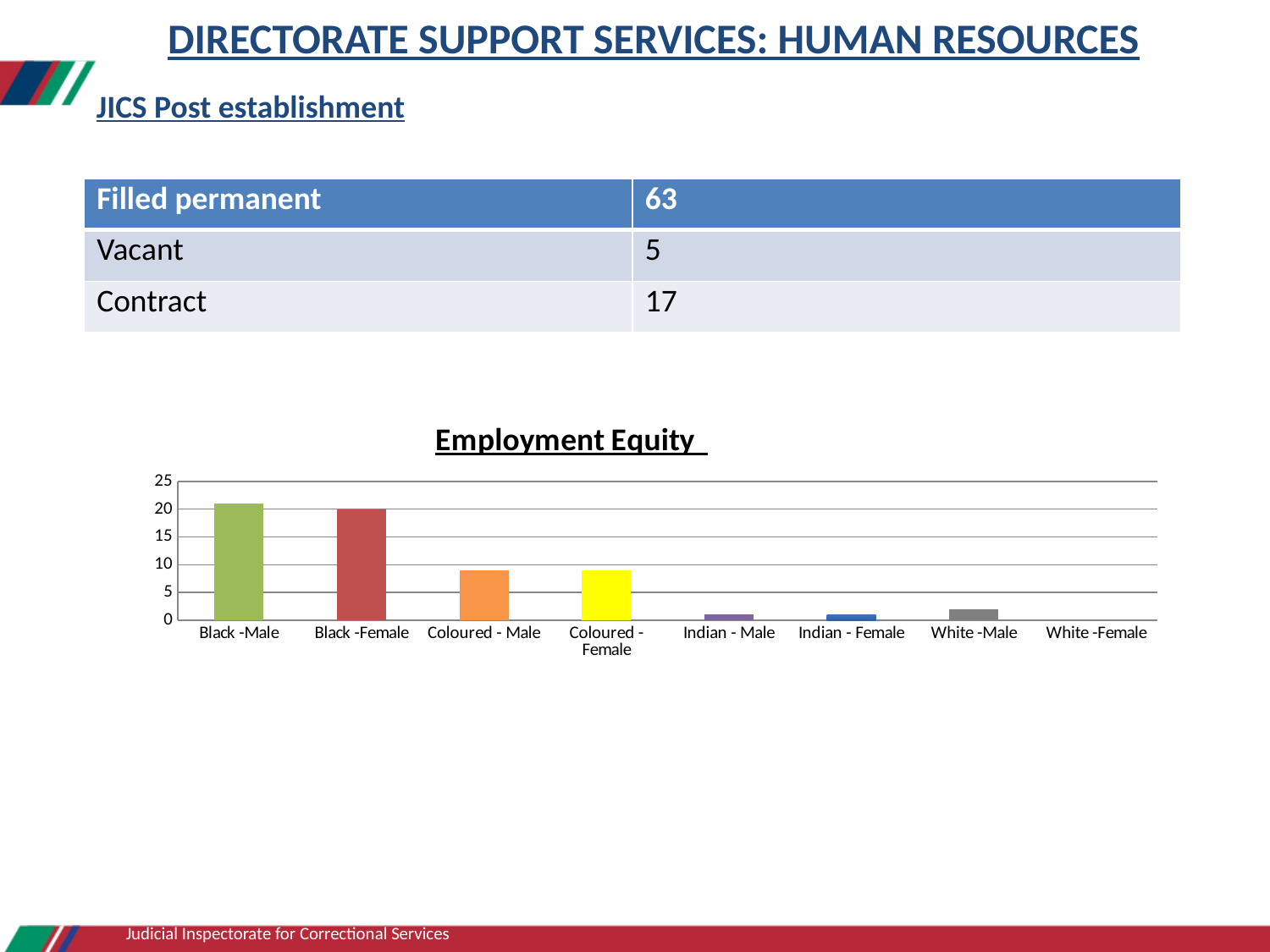
What kind of chart is the Employment Equity chart? bar chart In the Employment Equity chart, is the value for Coloured - Male greater or less than 10? less In the Employment Equity chart, is the value for Black -Male greater or less than 20? greater In the Employment Equity chart, which is larger: Black -Female or Coloured - Female? Black -Female In the Employment Equity chart, is the value for White -Male greater or less than 5? less What colour is the Coloured - Female bar in the Employment Equity chart? yellow How many categories are shown on the x axis of the Employment Equity chart? 8 What is the title of the chart on the slide? Employment Equity In the Employment Equity chart, which is larger: Coloured - Male or Indian - Male? Coloured - Male Which category has the highest value in the Employment Equity chart? Black -Male